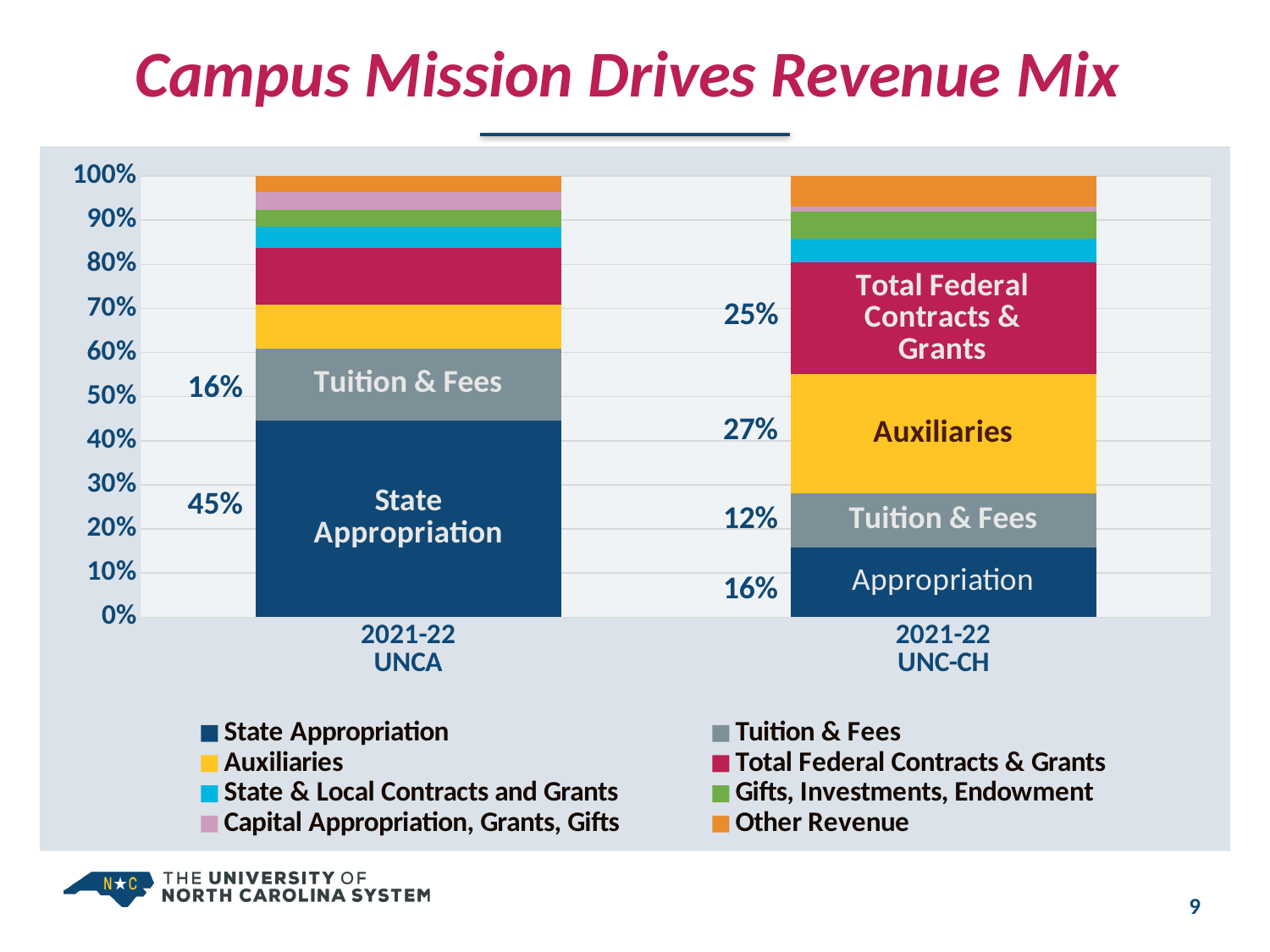
What percentage of UNC-CH's 2021-22 revenue comes from Tuition & Fees? 12% Which campus has the larger Tuition & Fees share, UNCA or UNC-CH? UNCA Which campus has the larger Auxiliaries share, UNCA or UNC-CH? UNC-CH How many revenue categories does the legend list? 8 How many percentage points higher is the State Appropriation share for UNCA than for UNC-CH? 29 percentage points What percentage of UNC-CH's 2021-22 revenue comes from Auxiliaries? 27% How many bars are shown in the chart? 2 What percentage of UNCA's 2021-22 revenue comes from State Appropriation? 45% What type of chart is shown on the slide? Stacked bar chart What percentage of UNC-CH's 2021-22 revenue comes from Appropriation? 16% What percentage of UNC-CH's 2021-22 revenue comes from Total Federal Contracts & Grants? 25% What percentage of UNCA's 2021-22 revenue comes from Tuition & Fees? 16%